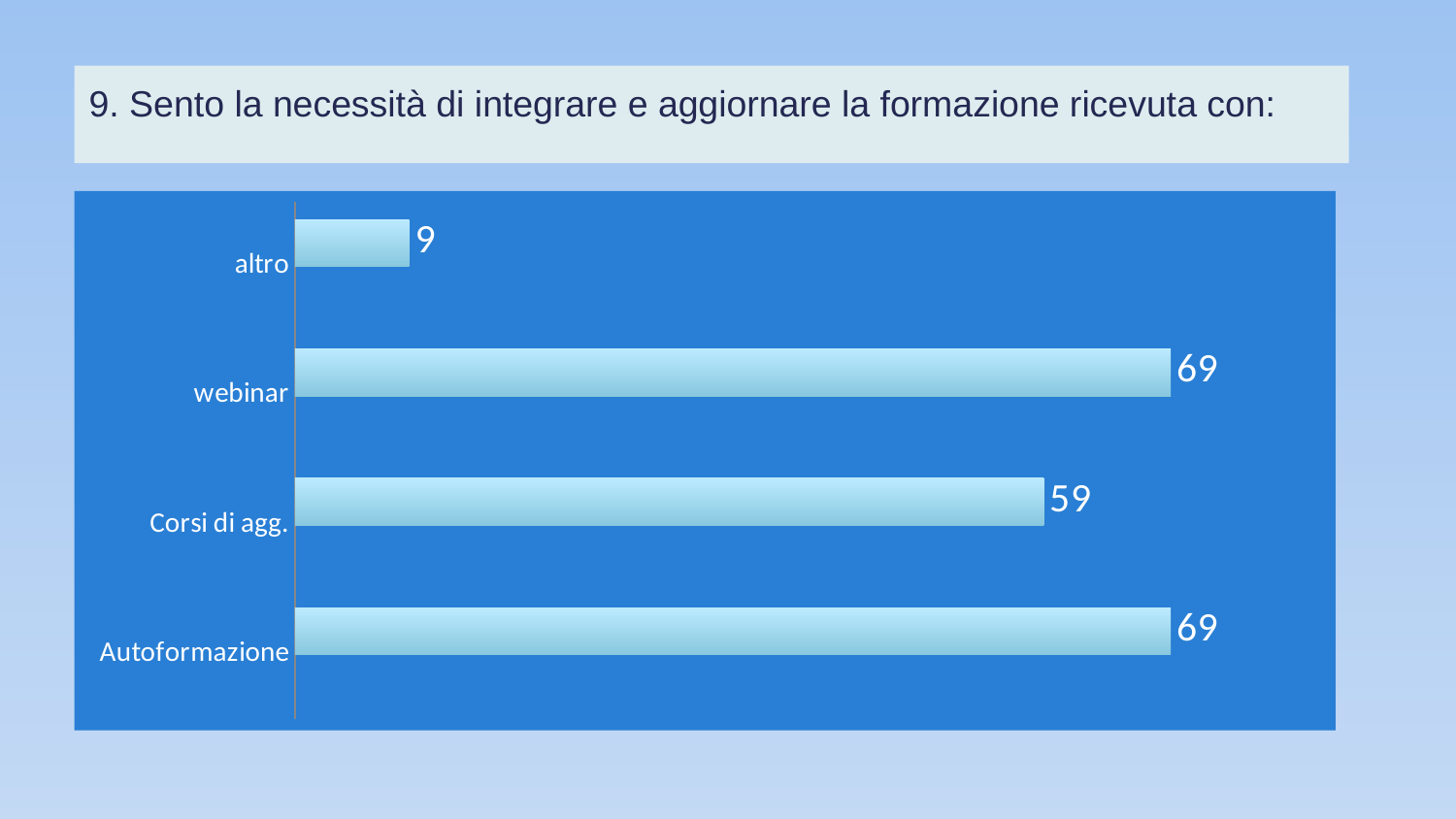
What is the value for altro? 9 What is the title text above the chart? 9. Sento la necessità di integrare e aggiornare la formazione ricevuta con: What is the difference between the values for webinar and Corsi di agg.? 10 Which is larger, the value for webinar or the value for Corsi di agg.? webinar Which category has the lowest value? altro What kind of chart is shown on the slide? bar chart What is the value for Corsi di agg.? 59 Which is larger, the value for Corsi di agg. or the value for altro? Corsi di agg. How many categories are shown in the chart? 4 What is the value for Autoformazione? 69 What is the difference between the values for Autoformazione and altro? 60 What is the value for webinar? 69